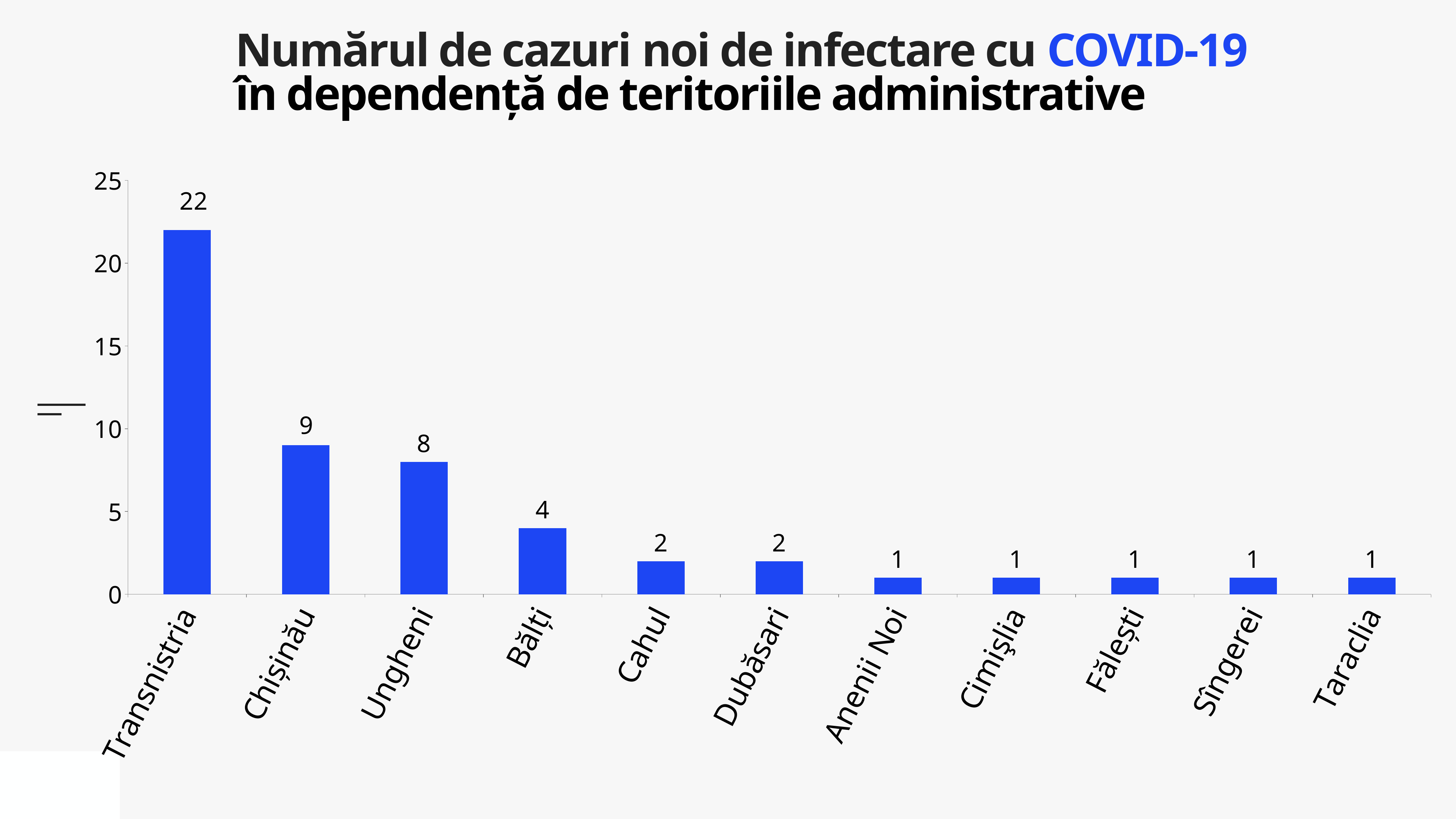
Do the values rise or fall from left to right along the x axis? fall Which is larger, the value for Chișinău or the value for Cahul? Chișinău How many categories are shown on the x axis? 11 What is the value for Ungheni? 8 What is the value for Bălți? 4 What is the difference between the values for Transnistria and Chișinău? 13 Is the value for Transnistria greater or less than 20? greater What is the difference between the values for Ungheni and Bălți? 4 What is the value for Chișinău? 9 What kind of chart is shown on the slide? bar chart What is the value for Transnistria? 22 Which category has the highest value? Transnistria